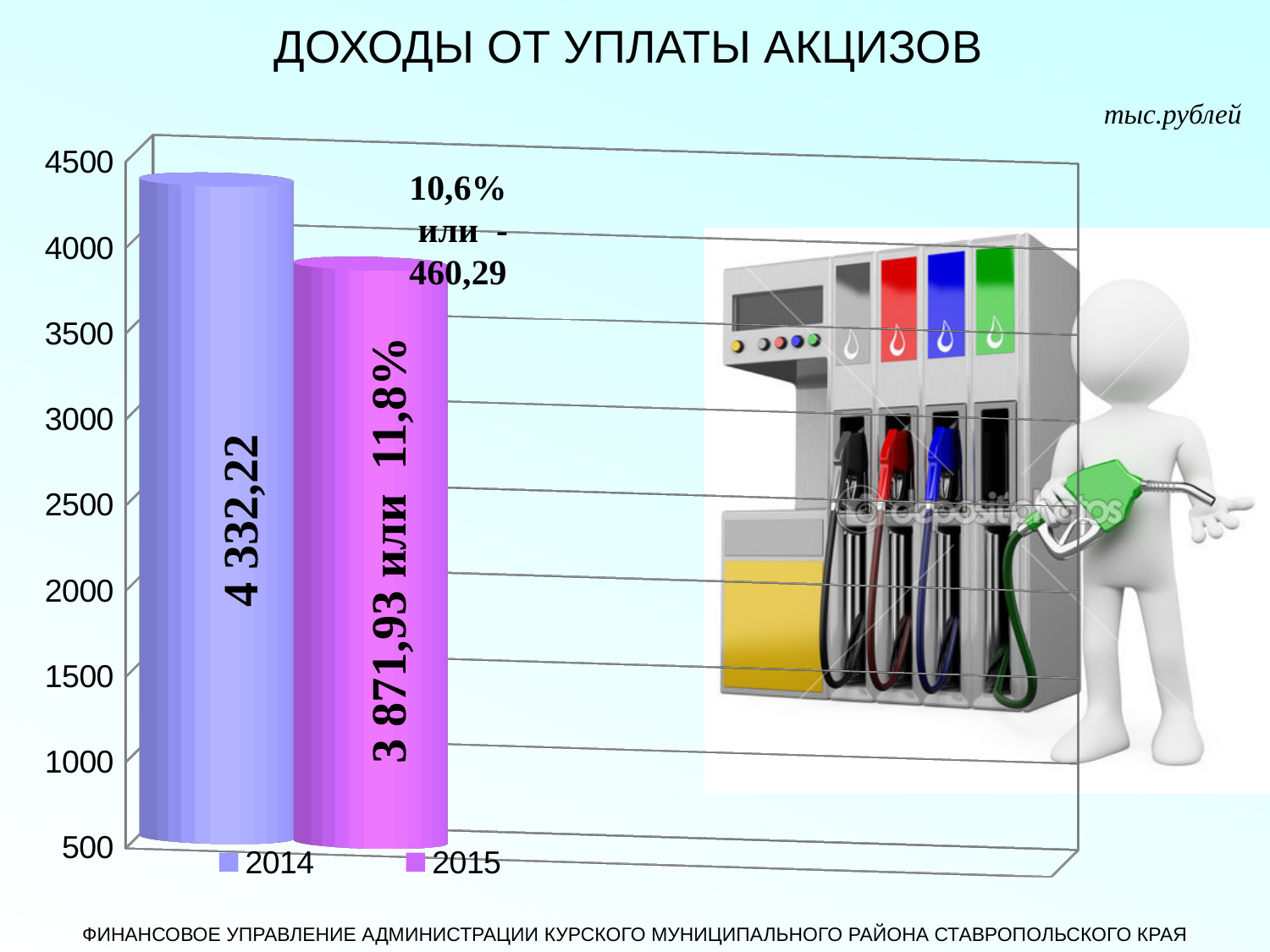
Is the value for 2015 greater or less than 4000? less Is the value for 2014 greater or less than 4000? greater What is the difference between the 2014 and 2015 values? 460,29 Which year has the higher value, 2014 or 2015? 2014 What is the value for 2015? 3 871,93 Do the values rise or fall from 2014 to 2015? fall What is the value for 2014? 4 332,22 How many entries does the legend list? 2 What unit of measurement is stated for the chart? тыс.рублей Which year has the lowest value? 2015 What kind of chart is shown on the slide? bar chart How many bars are plotted on the chart? 2